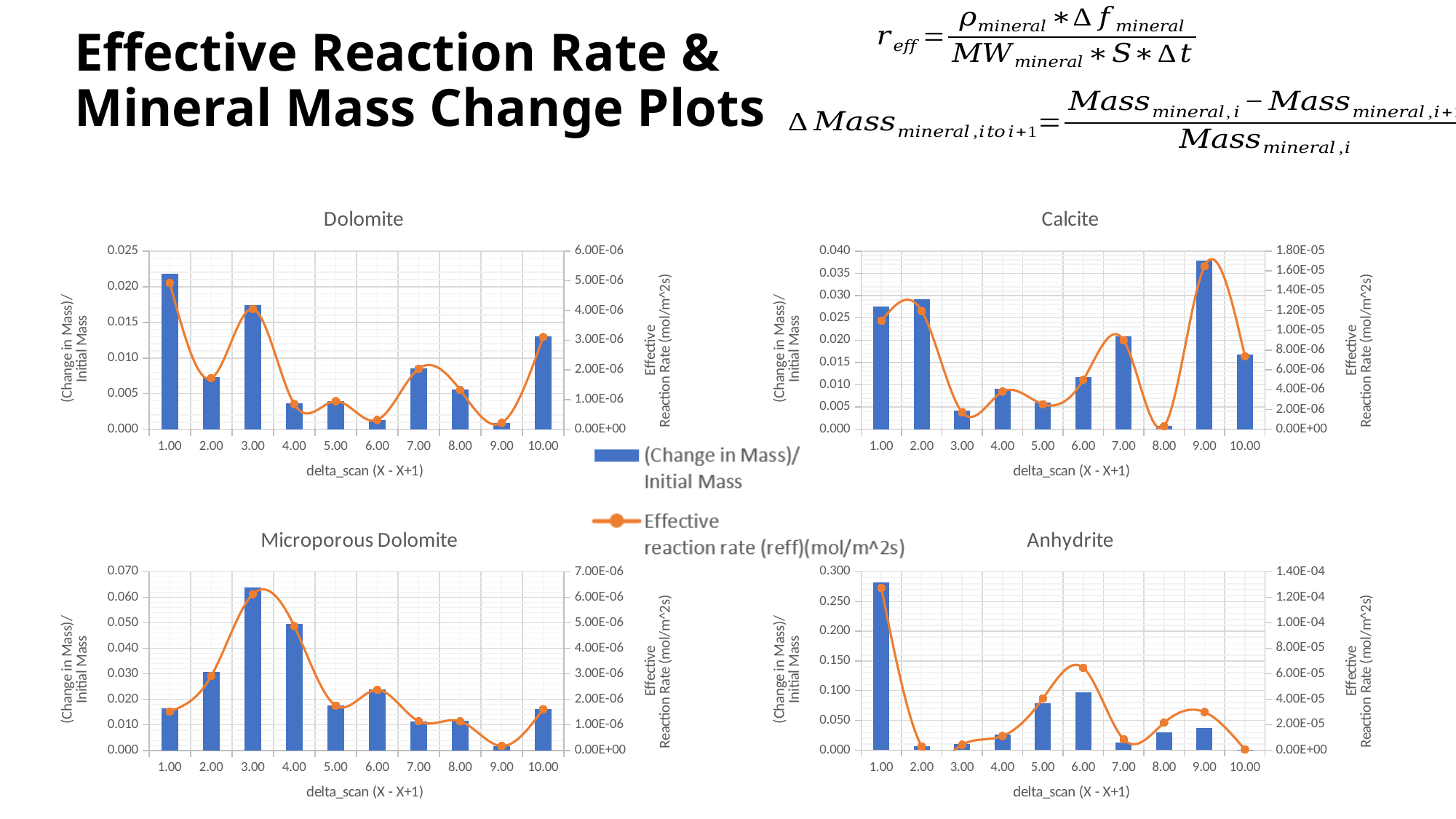
On the Anhydrite chart, which delta_scan category has the highest (Change in Mass)/Initial Mass bar? 1.00 On the Dolomite chart, which delta_scan category has the highest (Change in Mass)/Initial Mass bar? 1.00 On the Dolomite chart, which has the larger (Change in Mass)/Initial Mass bar, delta_scan 3.00 or 10.00? 3.00 On the Calcite chart, which delta_scan category has the highest (Change in Mass)/Initial Mass bar? 9.00 On the Calcite chart, is the (Change in Mass)/Initial Mass value for delta_scan 1.00 greater or less than 0.025? greater On the Anhydrite chart, is the (Change in Mass)/Initial Mass value for delta_scan 1.00 greater or less than 0.250? greater How many delta_scan categories are shown on the x axis of the Anhydrite chart? 10 On the Calcite chart, which delta_scan category has the lowest (Change in Mass)/Initial Mass bar? 8.00 On the Microporous Dolomite chart, which delta_scan category has the lowest (Change in Mass)/Initial Mass bar? 9.00 What is the label of the right-hand vertical axis on the Calcite chart? Effective Reaction Rate (mol/m^2s) How many series does the shared legend on the slide list? 2